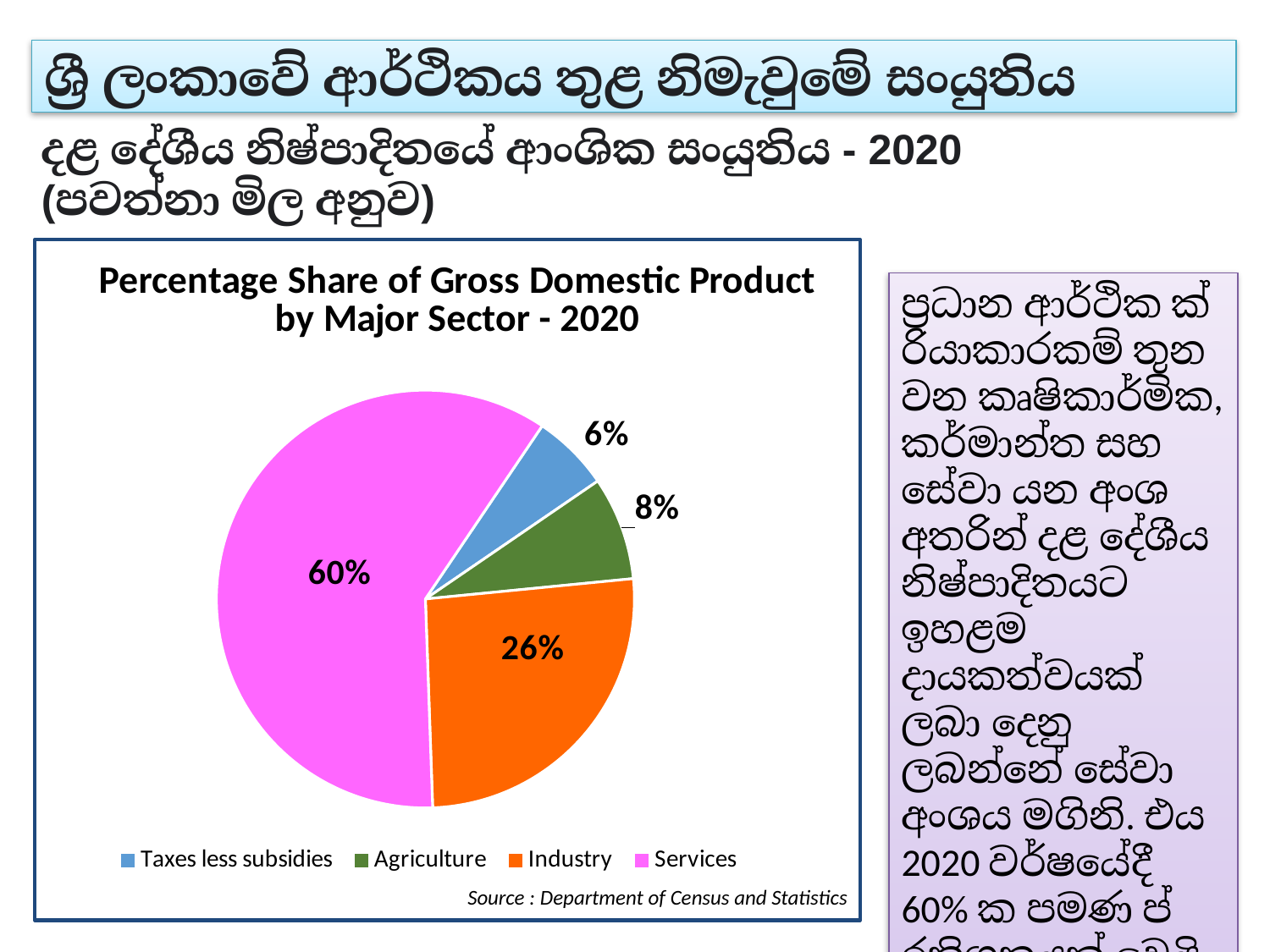
Which category has the smallest share in the pie chart? Taxes less subsidies What percentage share is shown for Agriculture? 8% How many entries does the legend of the pie chart list? 4 What percentage share is shown for Taxes less subsidies? 6% What is the difference in percentage points between the Services share and the Industry share? 34 Which sector has the largest share of GDP in the pie chart? Services What percentage share does Services have in the pie chart? 60% What is the title of the chart on the slide? Percentage Share of Gross Domestic Product by Major Sector - 2020 What type of chart is shown on the slide? Pie chart Which has a larger share of GDP, Agriculture or Industry? Industry How many slices does the pie chart have? 4 What is the percentage share of Industry in the pie chart? 26%